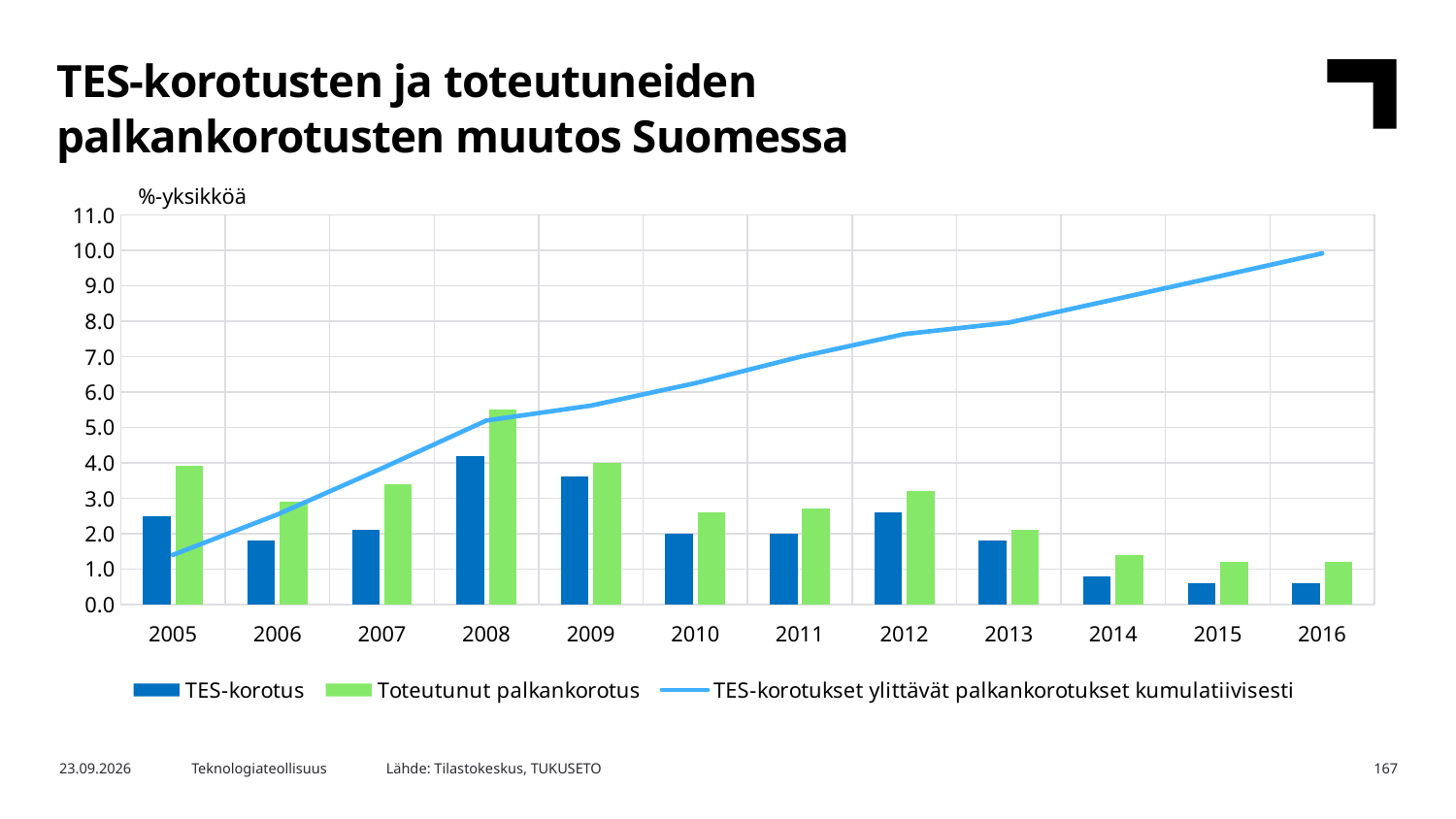
What unit label is shown above the vertical axis of the chart? %-yksikköä In 2005, which is larger: TES-korotus or Toteutunut palkankorotus? Toteutunut palkankorotus What kind of chart is shown on the slide? A combined bar and line chart How many series does the chart legend list? 3 Does the line 'TES-korotukset ylittävät palkankorotukset kumulatiivisesti' rise or fall from 2005 to 2016? It rises Is the value of the cumulative line in 2012 greater or less than 7.0? greater How many years are shown on the x axis of the chart? 12 Is the TES-korotus value for 2014 greater or less than 1.0? less In which year is the TES-korotus bar highest? 2008 Which is larger: the TES-korotus value for 2009 or for 2012? 2009 In which year is the Toteutunut palkankorotus bar highest? 2008 Is the Toteutunut palkankorotus value for 2008 greater or less than 5.0? greater